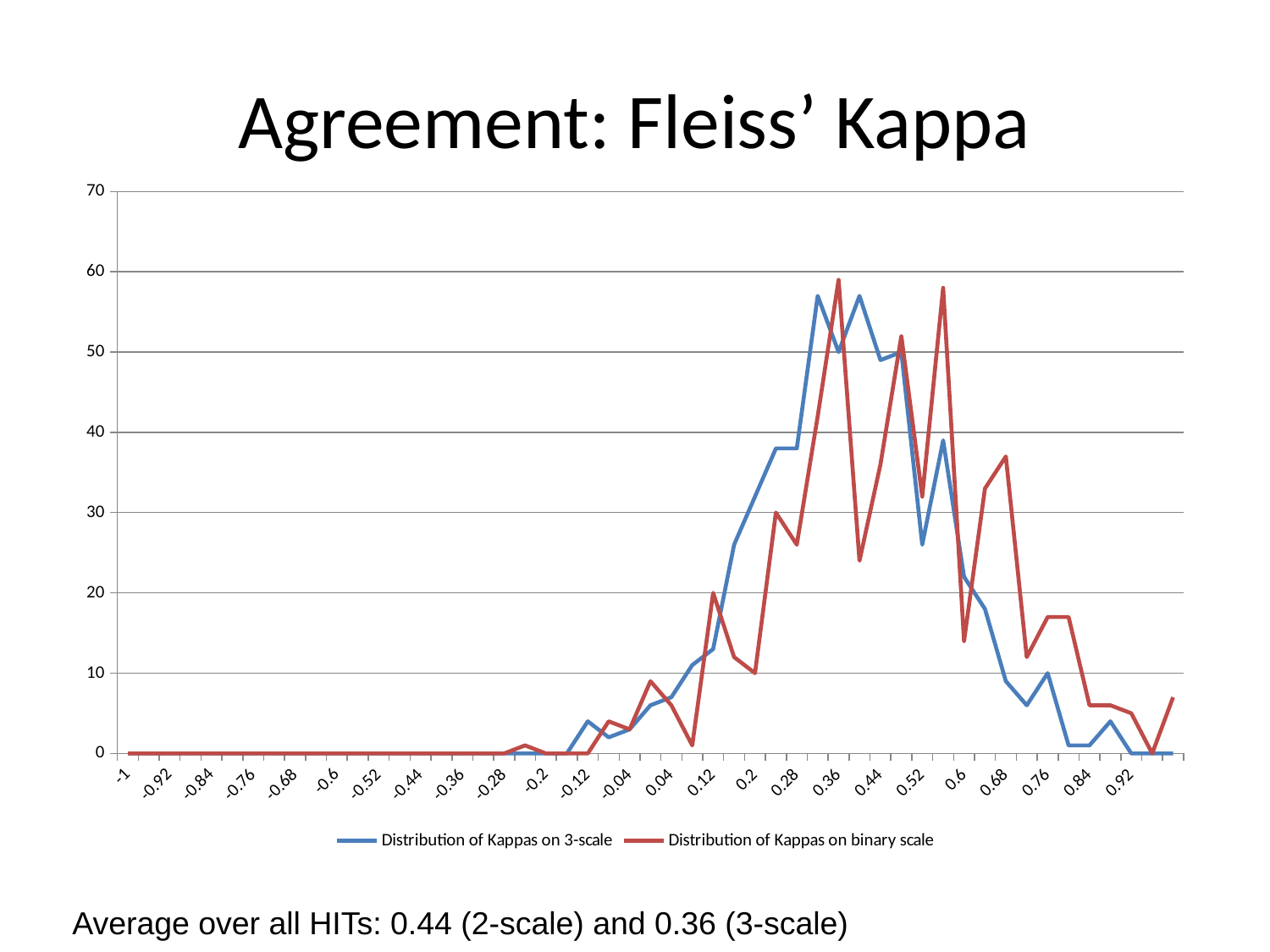
Is the value of the 'Distribution of Kappas on binary scale' series at 0.36 greater or less than 50? greater What is the title of the chart? Agreement: Fleiss' Kappa What is the value of the 'Distribution of Kappas on 3-scale' series at -0.6? 0 Which series is drawn in red? Distribution of Kappas on binary scale What is the value of the 'Distribution of Kappas on binary scale' series at -0.84? 0 How many series does the legend list? 2 Is the value of the 'Distribution of Kappas on binary scale' series at 0.44 greater or less than 30? greater At 0.68, which series has the larger value, 'Distribution of Kappas on 3-scale' or 'Distribution of Kappas on binary scale'? Distribution of Kappas on binary scale At 0.44, which series has the larger value, 'Distribution of Kappas on 3-scale' or 'Distribution of Kappas on binary scale'? Distribution of Kappas on 3-scale Does the 'Distribution of Kappas on 3-scale' series rise or fall between 0.04 and 0.36? rise What kind of chart is shown on the slide? line chart